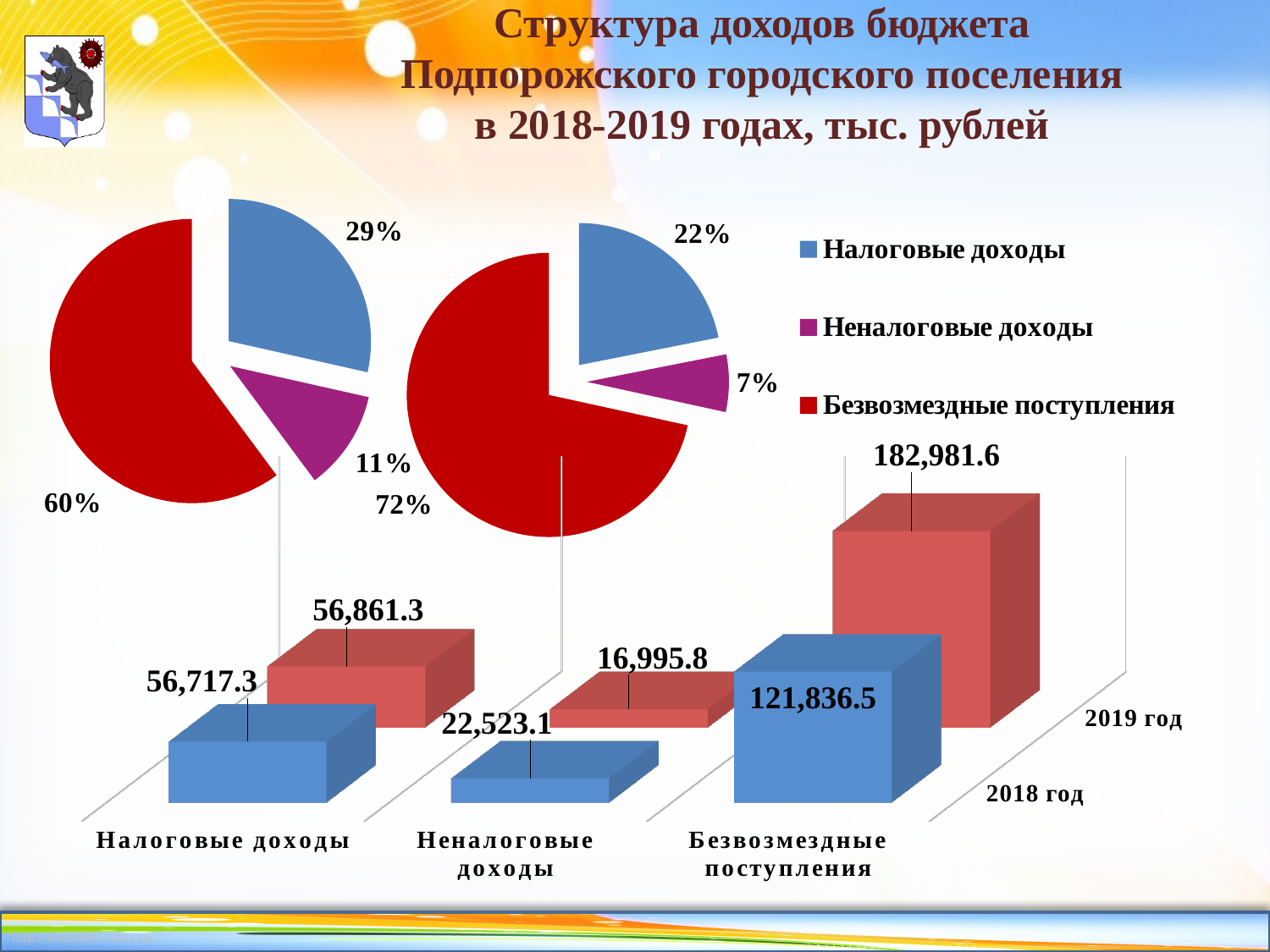
In the bar chart, what is the value for Налоговые доходы in 2019 год? 56,861.3 In the bar chart, which is larger for Неналоговые доходы: the 2018 год value or the 2019 год value? 2018 год How many categories are shown on the x axis of the bar chart? 3 In the bar chart, what is the value for Безвозмездные поступления in 2019 год? 182,981.6 In the left pie chart, what share does the red slice (Безвозмездные поступления) have? 60% In the right pie chart, which slice is the largest? Безвозмездные поступления How many entries does the legend list? 3 In the right pie chart, what share does the purple slice (Неналоговые доходы) have? 7% In the bar chart, what is the difference between the 2019 год and 2018 год values for Безвозмездные поступления? 61,145.1 In the bar chart, which category has the highest value in 2018 год? Безвозмездные поступления In the bar chart, which category has the lowest value in 2019 год? Неналоговые доходы In the bar chart, what is the value for Неналоговые доходы in 2018 год? 22,523.1